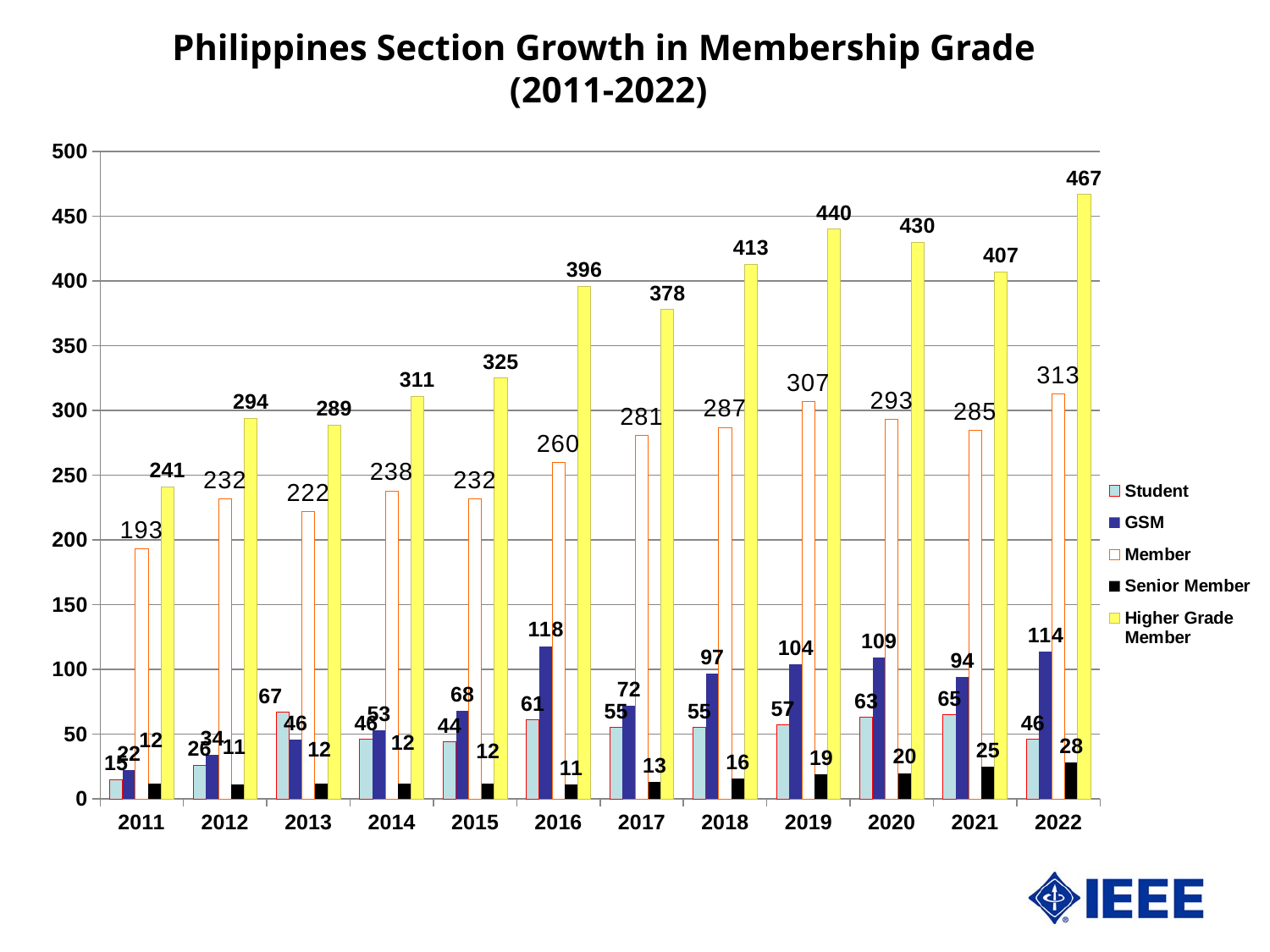
In which year is the Member value lowest? 2011 How many series does the legend list? 5 What is the value for GSM in 2016? 118 In which year is the Higher Grade Member value highest? 2022 What kind of chart is shown on the slide? Bar chart What is the value for Member in 2019? 307 What is the difference between the Higher Grade Member values in 2022 and 2011? 226 Which is larger, the GSM value in 2018 or the GSM value in 2019? 2019 What is the value for Senior Member in 2021? 25 What is the value for Higher Grade Member in 2022? 467 Does the Senior Member value rise or fall from 2018 to 2022? Rise How many years are shown on the x axis? 12